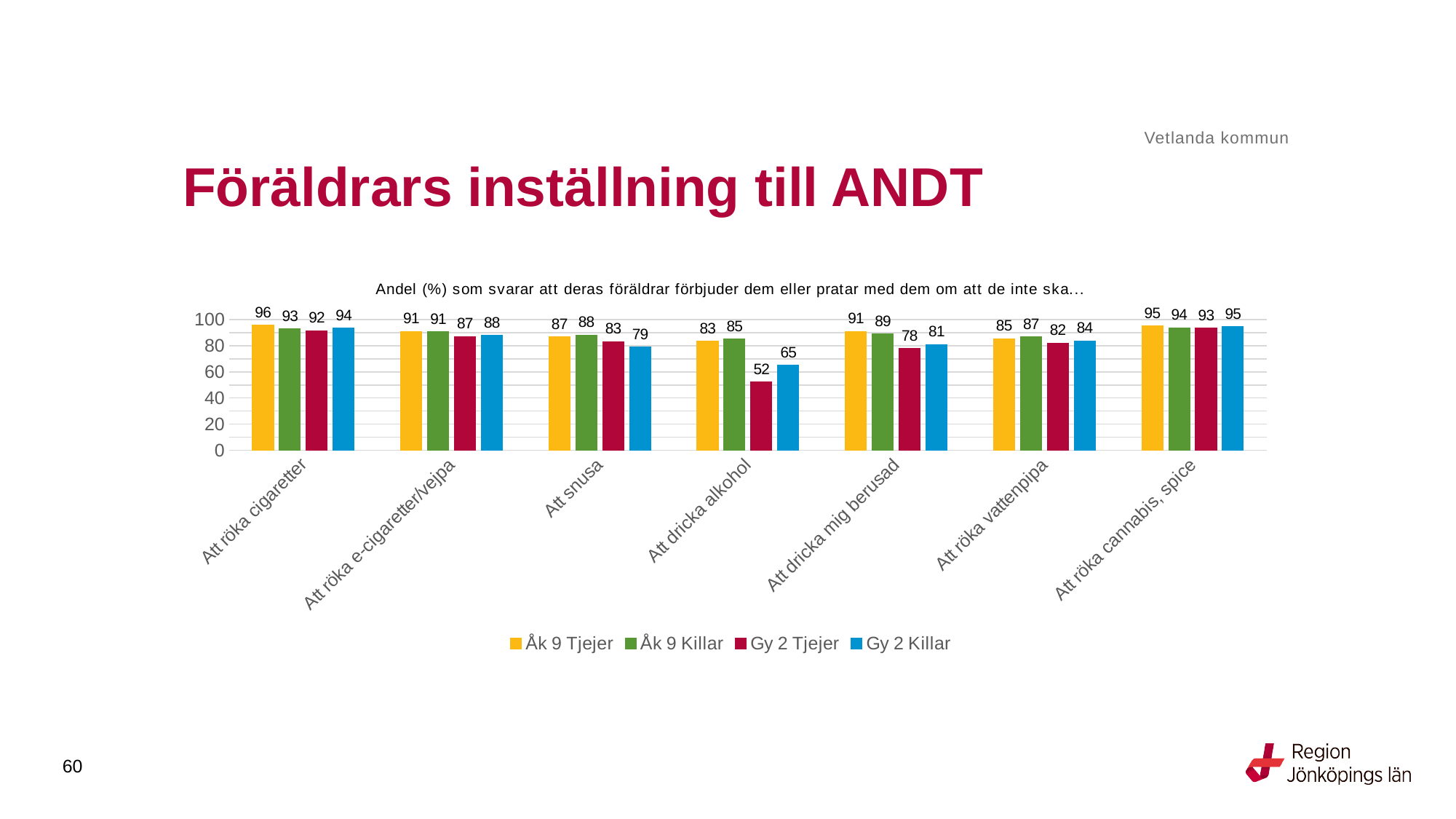
Which category has the highest value for Åk 9 Tjejer? Att röka cigaretter How many categories are shown on the x axis? 7 What is the difference between the Gy 2 Killar values for 'Att röka cannabis, spice' and 'Att dricka alkohol'? 30 Which series is shown in blue in the legend? Gy 2 Killar What is the value for Gy 2 Killar for 'Att dricka mig berusad'? 81 What is the difference between the Åk 9 Killar and Gy 2 Tjejer values for 'Att dricka alkohol'? 33 For 'Att snusa', which is larger: the value for Åk 9 Killar or Gy 2 Killar? Åk 9 Killar What kind of chart is shown on the slide? Bar chart Which category has the lowest value for Gy 2 Tjejer? Att dricka alkohol How many series does the legend list? 4 What is the value for Gy 2 Tjejer for 'Att dricka alkohol'? 52 What is the value for Åk 9 Tjejer for 'Att röka cigaretter'? 96